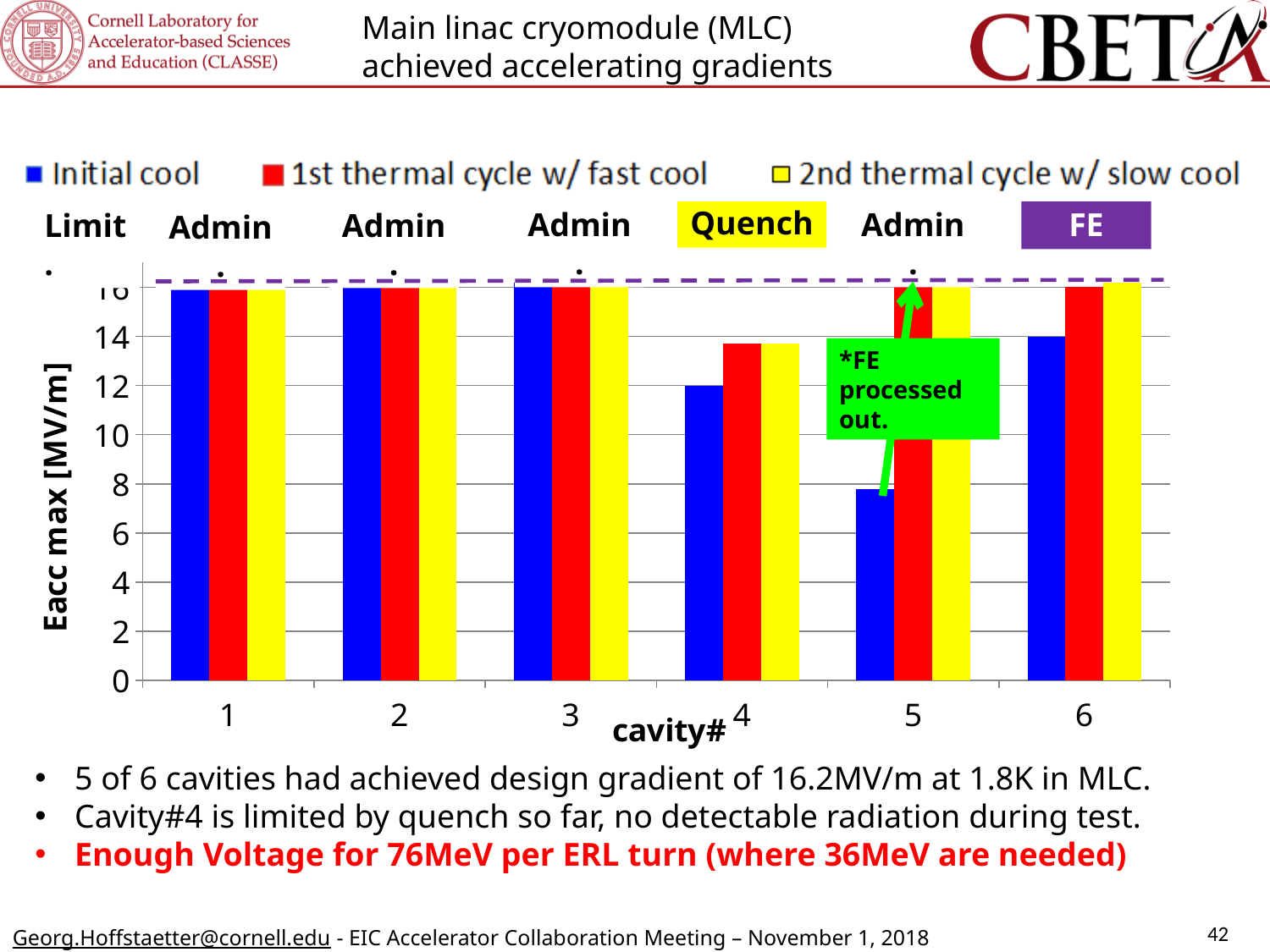
What kind of chart is shown on the slide? bar chart Is the 1st thermal cycle w/ fast cool value for cavity 4 greater or less than 12? greater What is the label of the y axis? Eacc max [MV/m] Is the Initial cool value for cavity 4 greater or less than 10? greater Which cavity has the lowest Initial cool value? 5 How many series does the legend list? 3 Is the Initial cool value for cavity 6 greater or less than 16? less How many cavities are shown along the x axis? 6 Which series is shown in yellow? 2nd thermal cycle w/ slow cool Which is larger, the Initial cool value for cavity 4 or for cavity 5? cavity 4 Which is larger for cavity 5, the Initial cool value or the 1st thermal cycle w/ fast cool value? 1st thermal cycle w/ fast cool